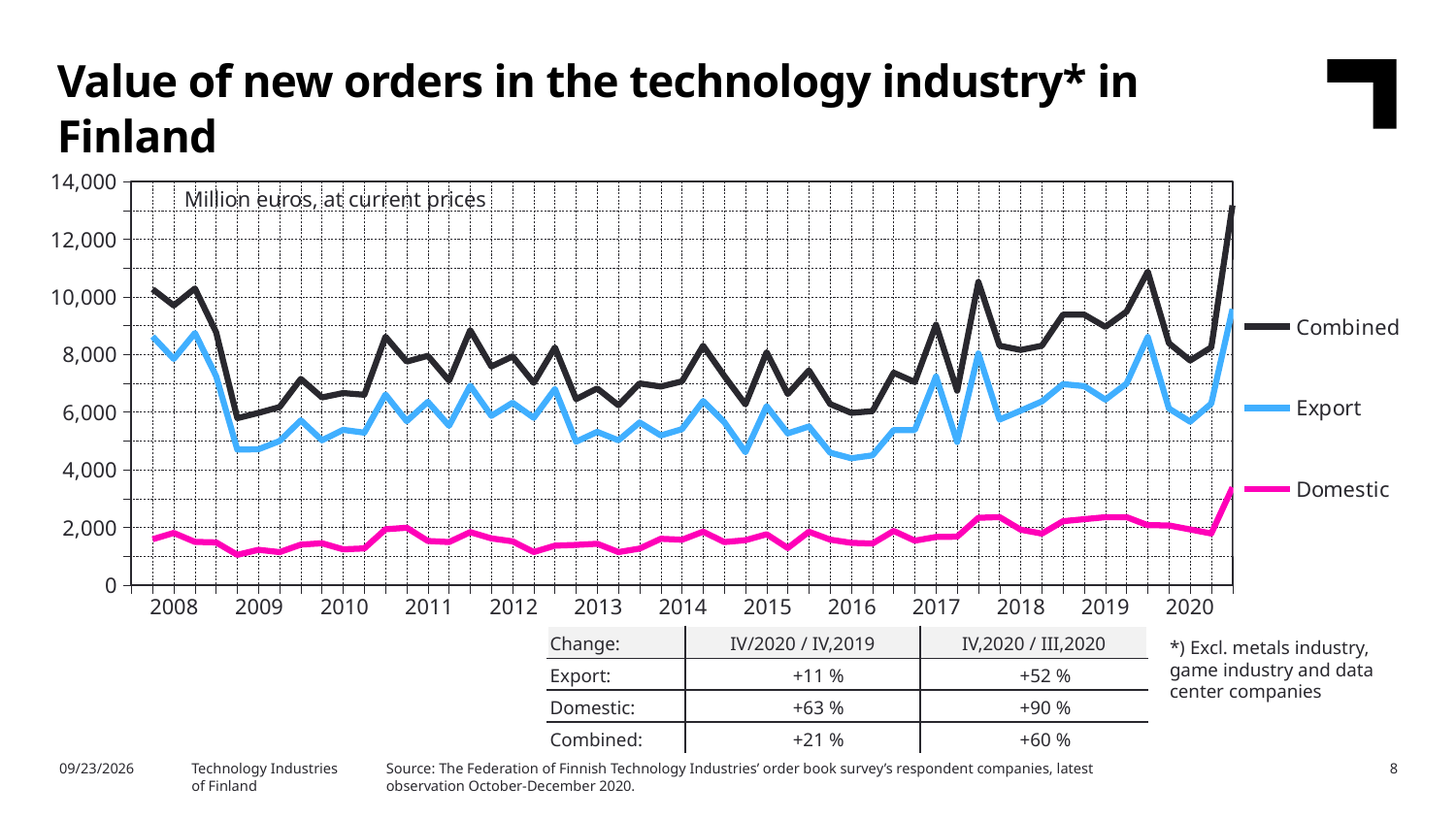
How many years are labelled on the x axis? 13 Does the Combined series rise or fall between the start of 2008 and 2009? fall Is the Domestic series ever greater or less than 4,000 across the whole chart? less Is the peak value of the Combined series at the end of 2020 greater or less than 12,000? greater Which series has the lowest values throughout the chart? Domestic Which is larger at the end of 2020, the Export value or the Domestic value? Export Is the Export value at the end of 2020 greater or less than 8,000? greater How many series does the legend list? 3 What kind of chart is shown on the slide? line chart What colour is the Export line in the legend? blue Which series has the highest values throughout the chart? Combined What unit is stated in the label inside the plot area? Million euros, at current prices